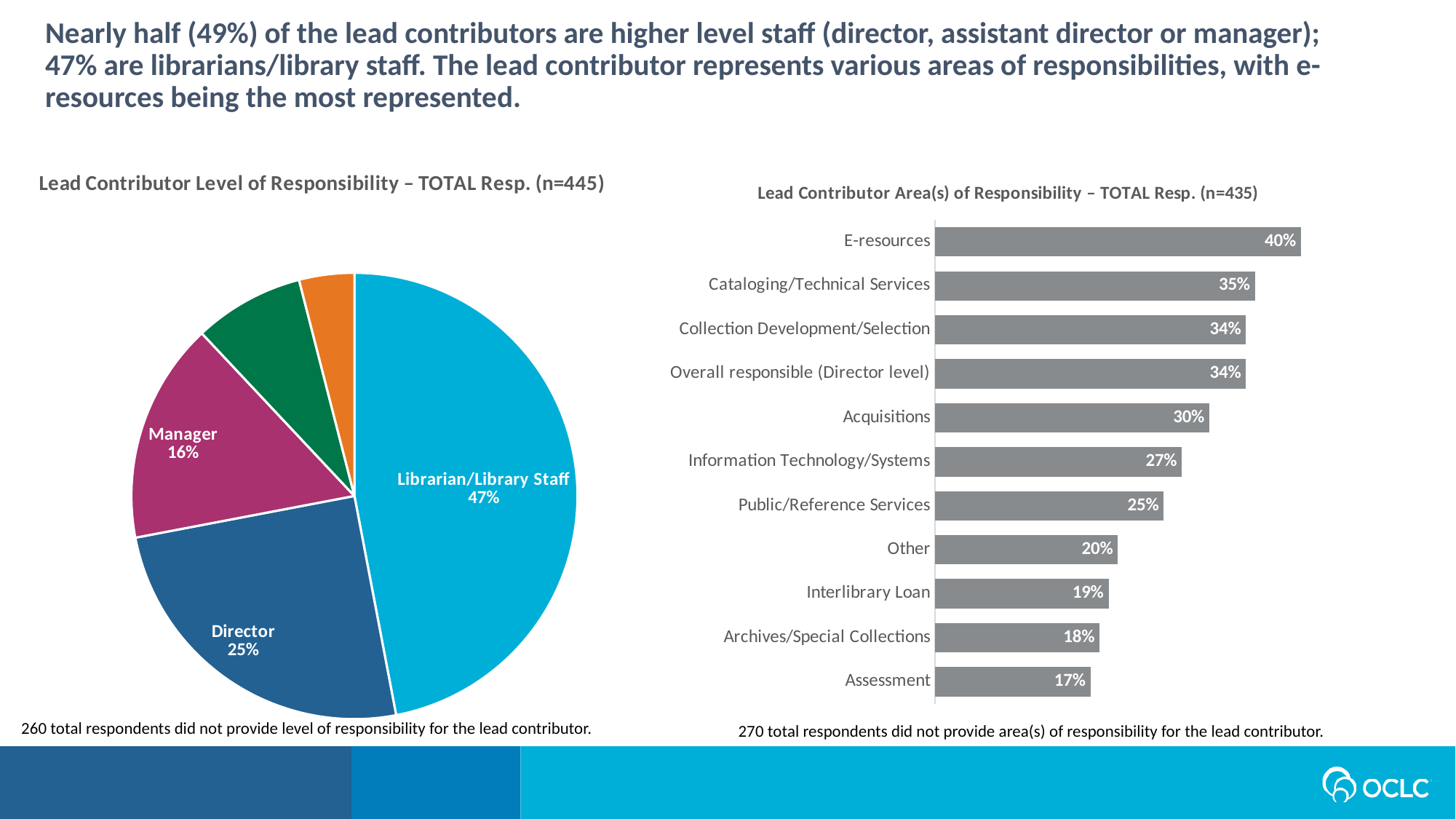
How many categories are shown in the 'Lead Contributor Area(s) of Responsibility' chart? 11 What kind of chart is the 'Lead Contributor Area(s) of Responsibility' chart? Bar chart In the 'Lead Contributor Area(s) of Responsibility' chart, what is the value for E-resources? 40% In the 'Lead Contributor Level of Responsibility' pie chart, what share is Manager? 16% In the 'Lead Contributor Area(s) of Responsibility' chart, which is larger: Public/Reference Services or Information Technology/Systems? Information Technology/Systems What kind of chart is the 'Lead Contributor Level of Responsibility' chart? Pie chart In the 'Lead Contributor Area(s) of Responsibility' chart, which category has the lowest value? Assessment In the 'Lead Contributor Area(s) of Responsibility' chart, what is the difference between Cataloging/Technical Services and Acquisitions? 5% In the 'Lead Contributor Level of Responsibility' pie chart, which labeled slice is the largest? Librarian/Library Staff In the 'Lead Contributor Area(s) of Responsibility' chart, which category has the highest value? E-resources In the 'Lead Contributor Area(s) of Responsibility' chart, what is the value for Interlibrary Loan? 19% In the 'Lead Contributor Level of Responsibility' pie chart, what share is Director? 25%